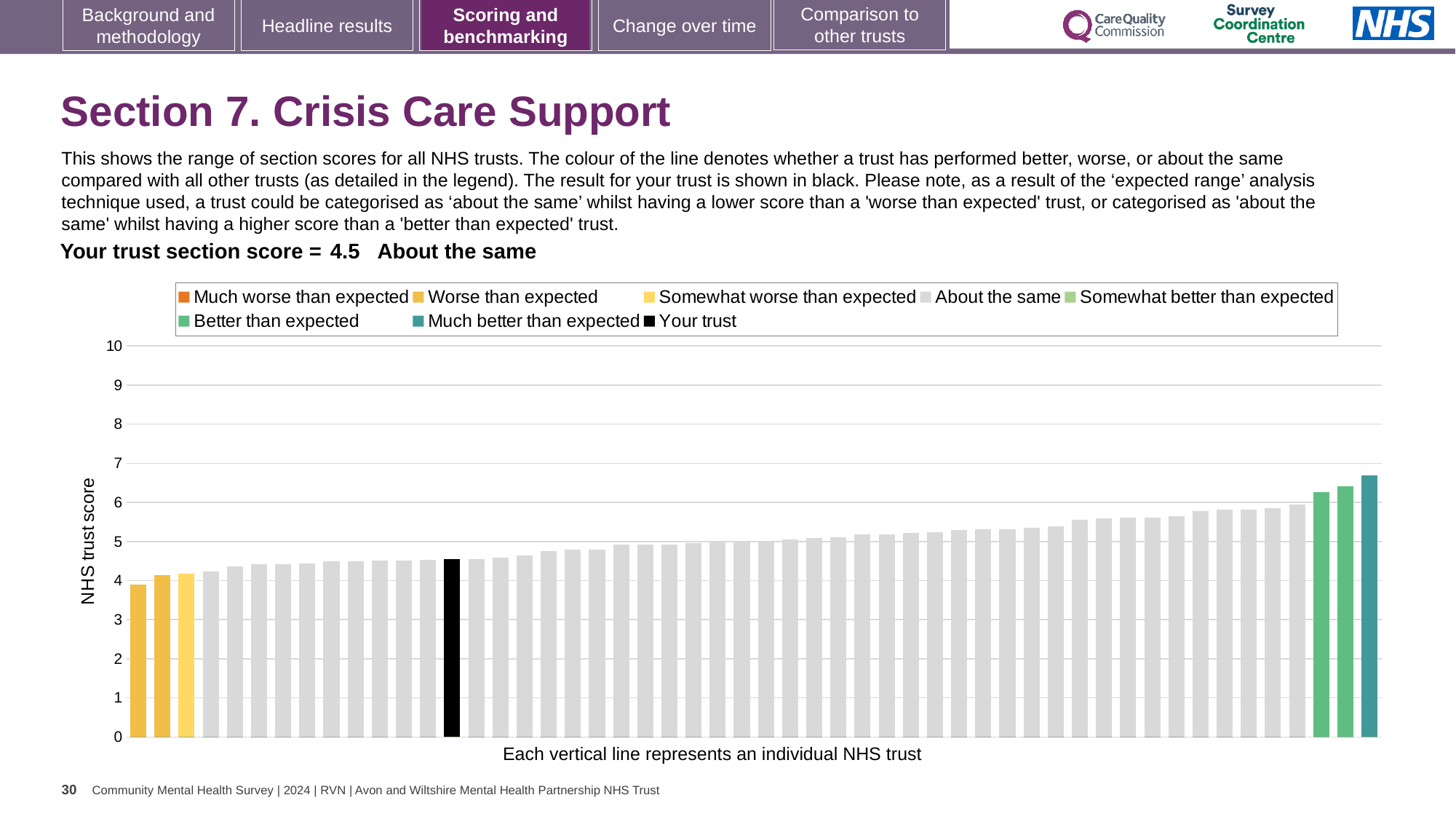
How many entries does the chart legend list? 8 Is the value for your trust (the black bar) greater or less than 5? less How many bars are coloured as 'Better than expected'? 2 Is the value of the lowest bar greater or less than 5? less What is the label on the y axis of the chart? NHS trust score Do the bar values rise or fall from left to right along the x axis? rise Is the value of the highest bar greater or less than 7? less What type of chart is shown on the slide? bar chart How many bars are coloured as 'Much better than expected'? 1 Which performance category is your trust placed in according to the slide? About the same What is the section score for your trust shown on the slide? 4.5